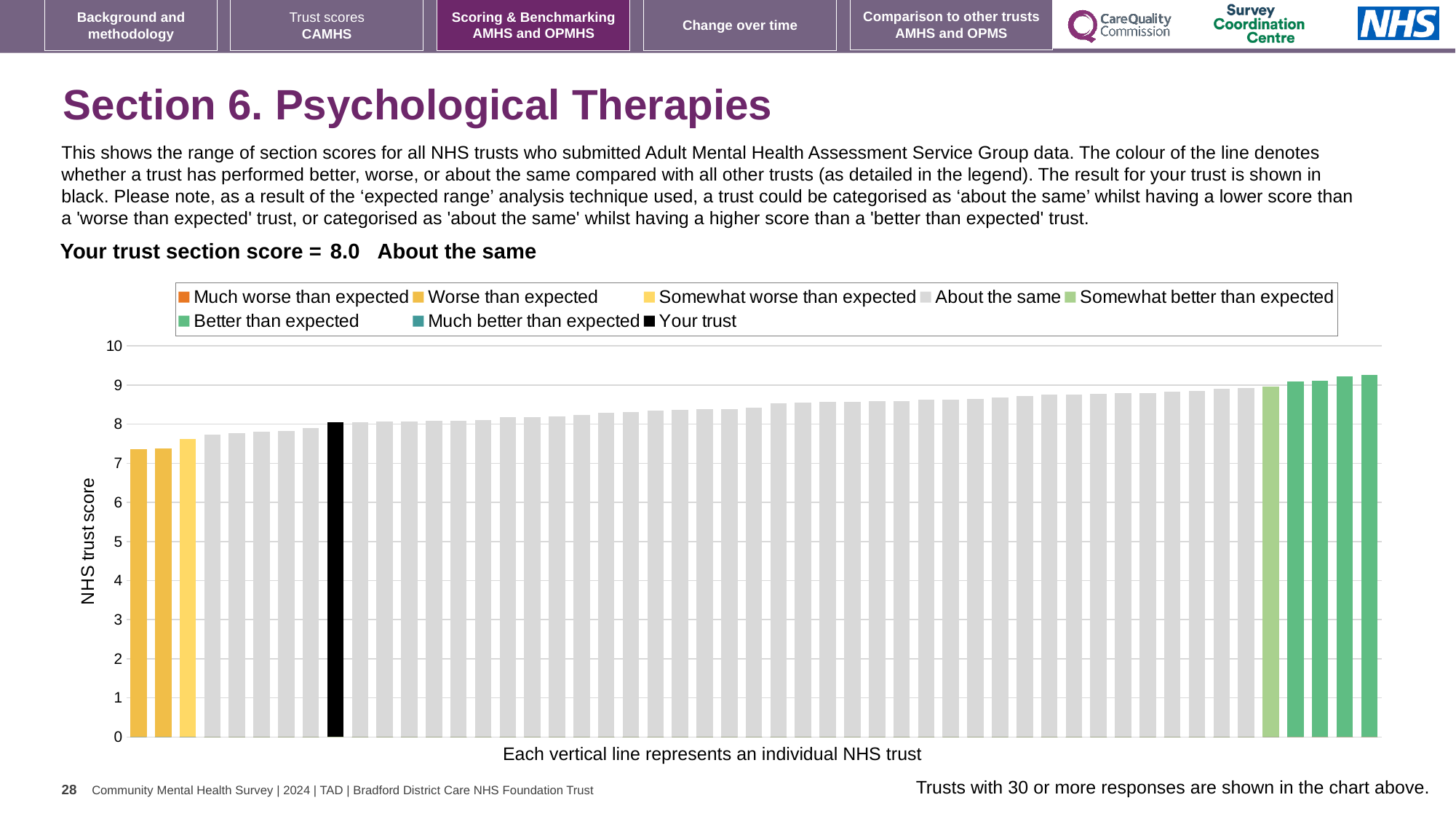
How many entries does the chart legend list? 8 What is the label on the vertical axis of the chart? NHS trust score What is the section score for your trust shown on the slide? 8.0 Is the black 'Your trust' bar higher or lower than the yellow 'Worse than expected' bars? higher Is the value of the tallest bar in the chart greater or less than 9? greater Which category does your trust's score fall into according to the slide? About the same What kind of chart is shown on the slide? bar chart Is the value of the shortest bar in the chart greater or less than 8? less Is the value of the shortest bar in the chart greater or less than 7? greater How many bars are coloured as 'Worse than expected' (yellow)? 2 Do the bar values rise or fall from left to right along the x axis? rise What colour is used for 'Your trust' in the chart legend? black